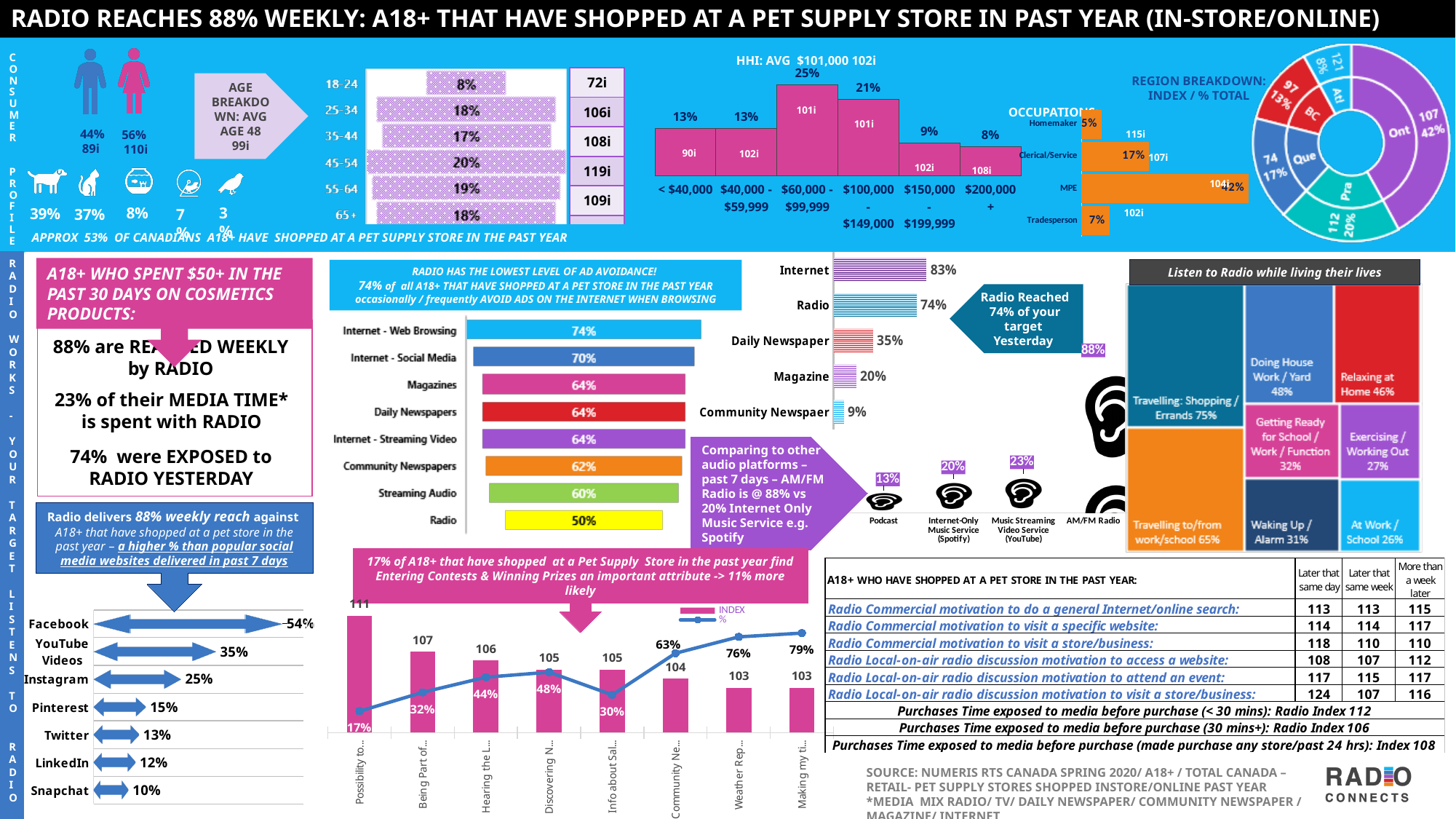
In the media reached yesterday bar chart (Internet, Radio, Daily Newspaper, Magazine, Community Newspaper), what is the value for Daily Newspaper? 35% In the social media bar chart at the bottom left (Facebook through Snapchat), what is the value for Instagram? 25% In the ad avoidance bar chart (Internet - Web Browsing through Radio), how many categories are shown? 8 In the HHI bar chart at the top, what is the value for the $60,000 - $99,999 category? 25% In the media reached yesterday bar chart (Internet, Radio, Daily Newspaper, Magazine, Community Newspaper), which is larger, Internet or Radio? Internet In the ad avoidance bar chart (Internet - Web Browsing through Radio), which category has the highest value? Internet - Web Browsing In the ad avoidance bar chart (Internet - Web Browsing through Radio), what is the difference between Internet - Social Media and Streaming Audio? 10% In the HHI bar chart at the top, which income category has the lowest percentage? $200,000 + In the age breakdown bar chart at the top, what is the value for the 45-54 age group? 20% In the ad avoidance bar chart (Internet - Web Browsing through Radio), what is the value for Radio? 50% In the audio platforms chart (Podcast, Internet-Only Music Service, Music Streaming Video Service, AM/FM Radio), what is the value for Podcast? 13% In the social media bar chart at the bottom left (Facebook through Snapchat), which category has the lowest value? Snapchat